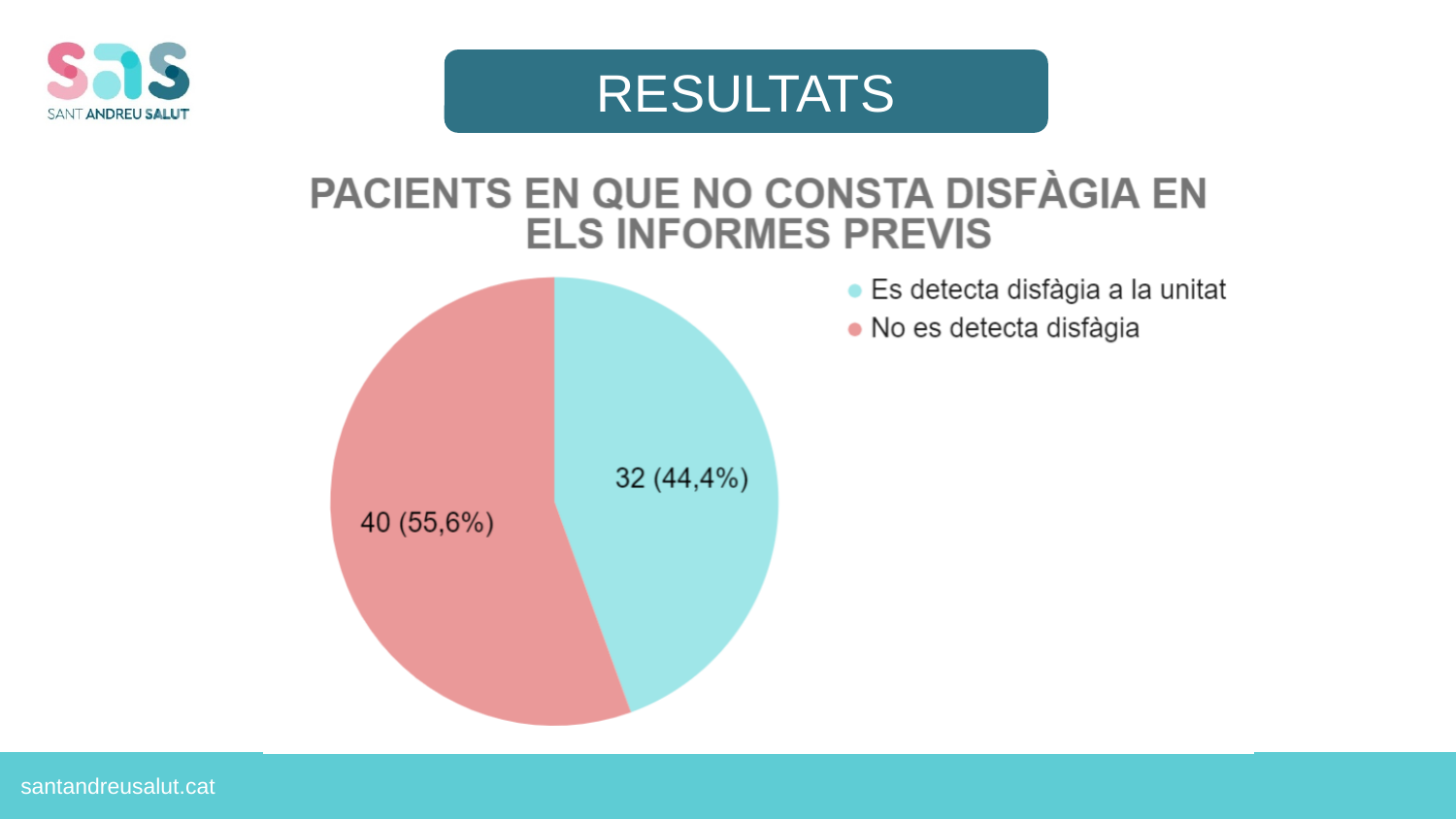
What is the total number of patients represented in the pie chart? 72 What share of the pie does 'No es detecta disfàgia' represent? 55,6% How many entries does the legend list? 2 How many slices does the pie chart have? 2 What is the count for 'No es detecta disfàgia'? 40 Which category has the smallest slice? Es detecta disfàgia a la unitat What is the title of the chart? PACIENTS EN QUE NO CONSTA DISFÀGIA EN ELS INFORMES PREVIS What share of the pie does 'Es detecta disfàgia a la unitat' represent? 44,4% What is the difference in count between 'No es detecta disfàgia' and 'Es detecta disfàgia a la unitat'? 8 What kind of chart is shown on the slide? pie chart Which category has the largest slice? No es detecta disfàgia What is the count for 'Es detecta disfàgia a la unitat'? 32